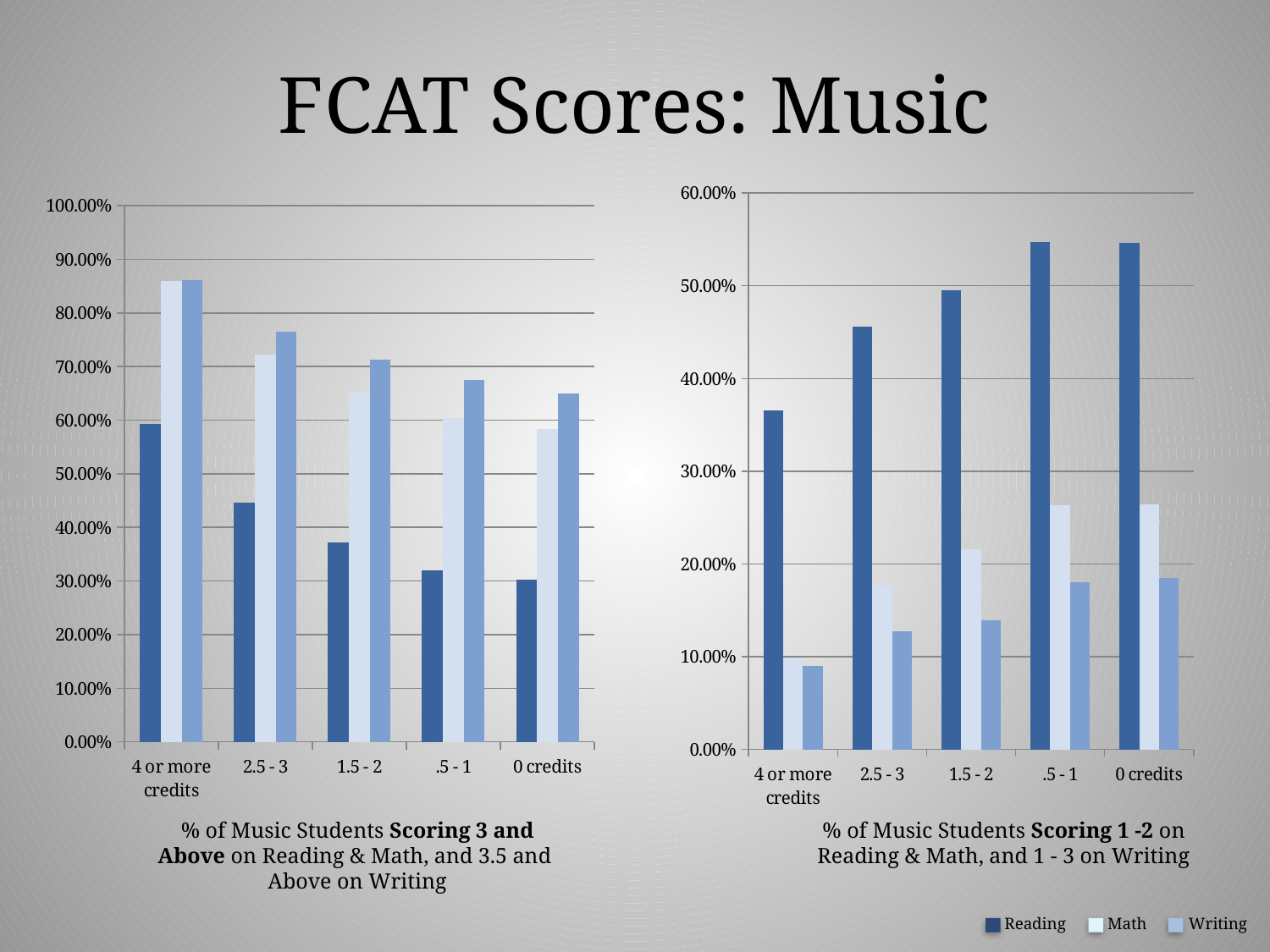
In the left chart, '% of Music Students Scoring 3 and Above', is the Reading value for '4 or more credits' greater or less than 50.00%? greater In the left chart, '% of Music Students Scoring 3 and Above', which credit category has the highest Math value? 4 or more credits In the left chart, '% of Music Students Scoring 3 and Above', do the Reading values rise or fall from '4 or more credits' to '0 credits'? fall In the left chart, '% of Music Students Scoring 3 and Above', is the Reading value for '0 credits' greater or less than 40.00%? less What kind of chart is the left chart, '% of Music Students Scoring 3 and Above'? bar chart How many credit categories are shown on the x axis of the left chart, '% of Music Students Scoring 3 and Above'? 5 What are the three series named in the legend? Reading, Math, Writing In the left chart, '% of Music Students Scoring 3 and Above', for the '2.5 - 3' category, which is larger: Reading or Writing? Writing In the right chart, '% of Music Students Scoring 1 -2', is the Reading value for '1.5 - 2' greater or less than 40.00%? greater In the right chart, '% of Music Students Scoring 1 -2', for the '4 or more credits' category, which is larger: Reading or Math? Reading In the right chart, '% of Music Students Scoring 1 -2', which credit category has the lowest Writing value? 4 or more credits How many series does the legend on the slide list? 3